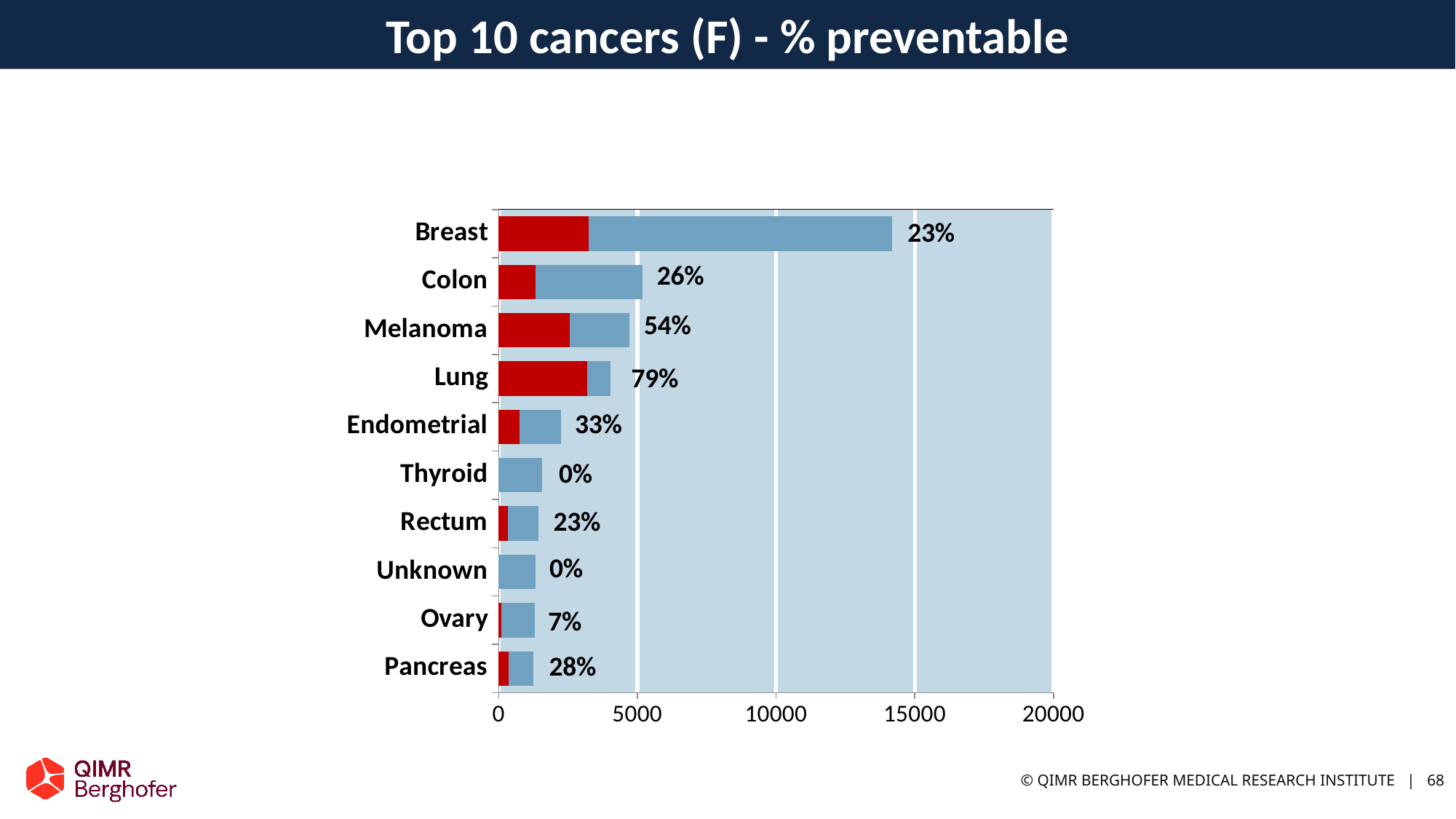
What percentage label is shown for Endometrial? 33% What percentage label is shown for Lung? 79% Which cancer has the highest percentage label? Lung How many cancer categories are shown on the chart? 10 Is the total bar length for Lung greater or less than 5000? less Which cancer has the longest bar? Breast What percentage label is shown for Ovary? 7% What type of chart is shown on the slide? Bar chart Is the total bar length for Breast greater or less than 10000? greater What is the difference in percentage points between the labels for Lung and Breast? 56 percentage points Which has the higher percentage label, Melanoma or Colon? Melanoma What percentage label is shown for Melanoma? 54%